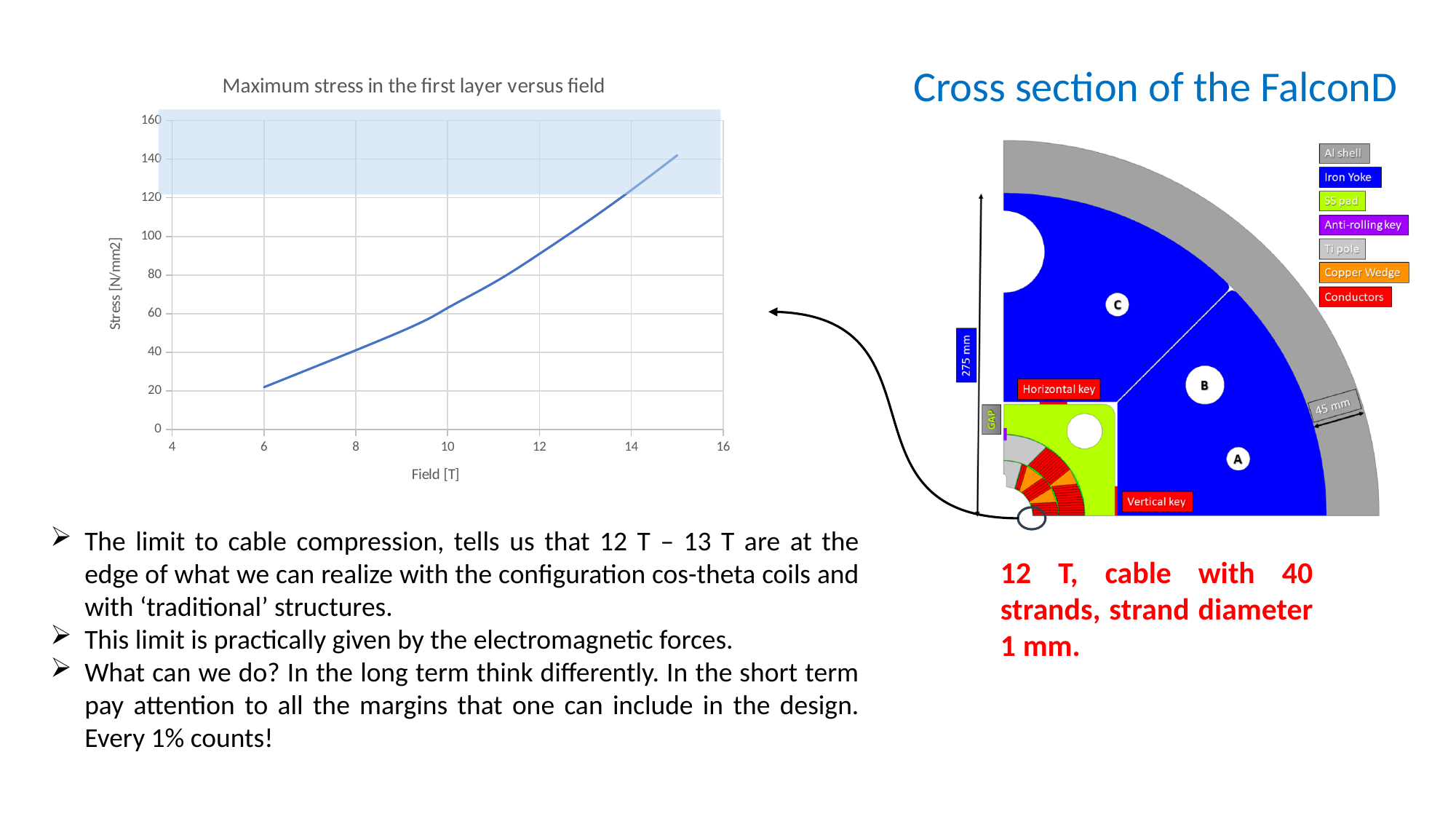
What is the title of the chart? Maximum stress in the first layer versus field Is the stress value at a field of 14 T greater or less than 100 N/mm2? greater What kind of chart is shown on the slide? line chart What is the label of the y axis of the chart? Stress [N/mm2] Is the stress value at a field of 12 T greater or less than 100 N/mm2? less Is the stress value at a field of 6 T greater or less than 40 N/mm2? less Does the stress rise or fall as the field increases along the x axis? rise Which field value has the higher stress on the chart, 8 T or 14 T? 14 T